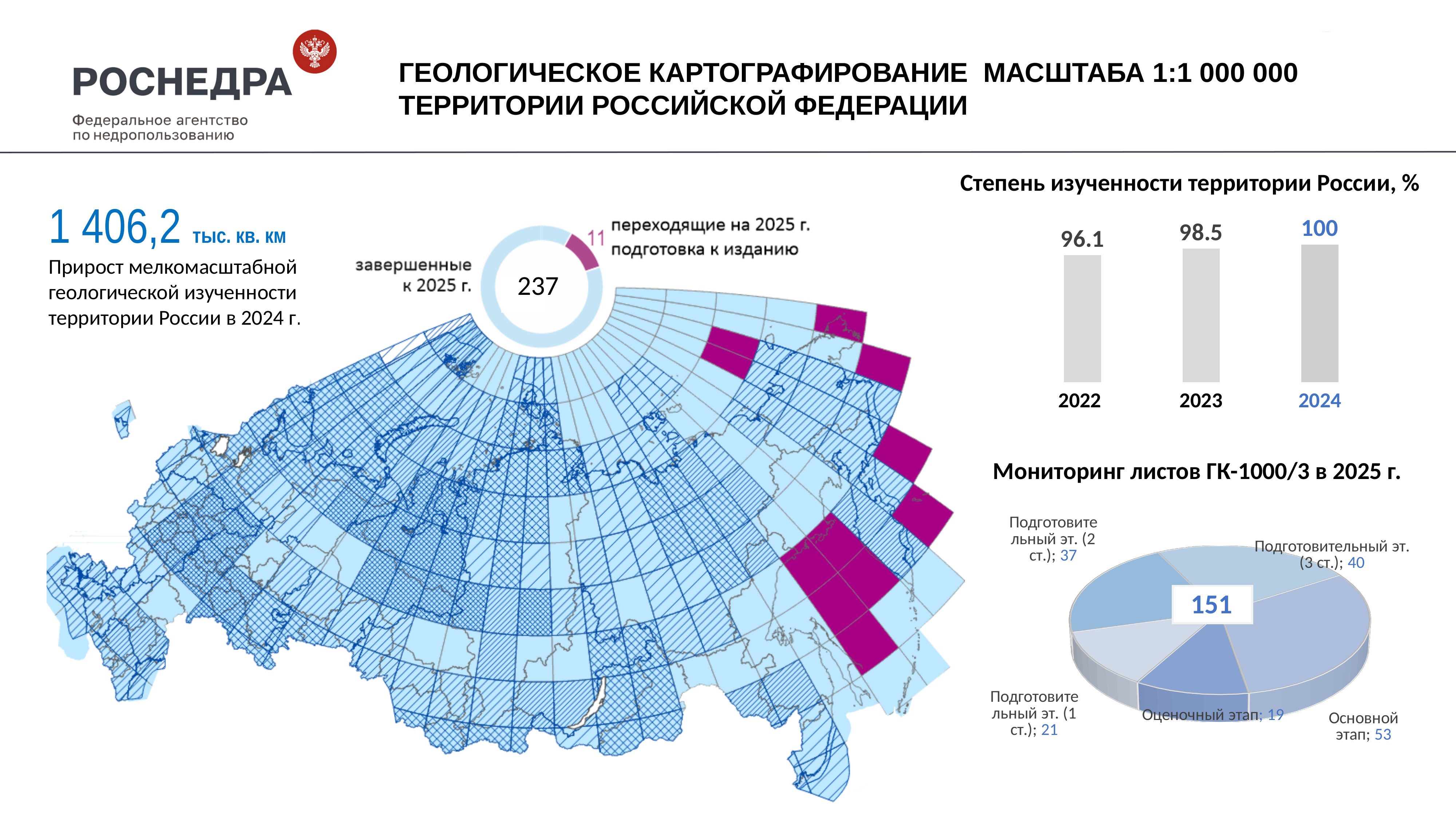
In the pie chart 'Мониторинг листов ГК-1000/3 в 2025 г.', which category has the largest value? Основной этап In the bar chart 'Степень изученности территории России, %', what is the value for 2023? 98.5 In the donut chart on the map, what is the value for 'переходящие на 2025 г. подготовка к изданию'? 11 In the pie chart 'Мониторинг листов ГК-1000/3 в 2025 г.', what is the value for 'Оценочный этап'? 19 In the pie chart 'Мониторинг листов ГК-1000/3 в 2025 г.', what is the value for 'Основной этап'? 53 In the bar chart 'Степень изученности территории России, %', which year has the lowest value? 2022 In the bar chart 'Степень изученности территории России, %', what is the difference between the 2024 and 2022 values? 3.9 In the bar chart 'Степень изученности территории России, %', do the values rise or fall from 2022 to 2024? rise In the pie chart 'Мониторинг листов ГК-1000/3 в 2025 г.', which is larger: 'Подготовительный эт. (2 ст.)' or 'Подготовительный эт. (1 ст.)'? Подготовительный эт. (2 ст.) In the bar chart 'Степень изученности территории России, %', which year has the highest value? 2024 In the bar chart 'Степень изученности территории России, %', what is the value for 2022? 96.1 How many bars are in the bar chart 'Степень изученности территории России, %'? 3